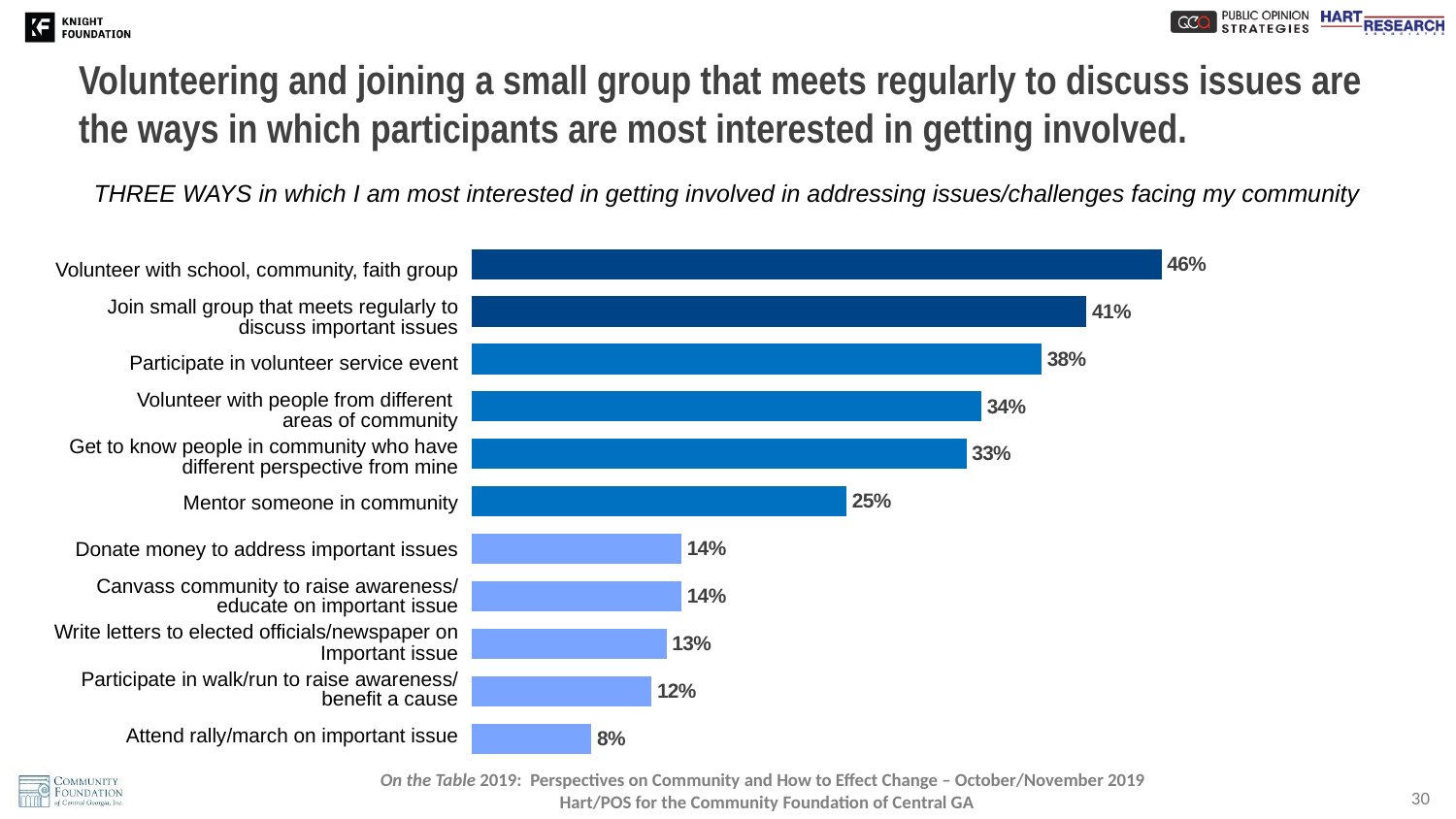
What percentage chose "Attend rally/march on important issue"? 8% What is the value for "Write letters to elected officials/newspaper on important issue"? 13% Which category has the highest value on the chart? Volunteer with school, community, faith group What percentage of participants are most interested in volunteering with a school, community, or faith group? 46% What is the value for "Mentor someone in community"? 25% Which is larger: the value for "Participate in volunteer service event" or the value for "Mentor someone in community"? Participate in volunteer service event Which category has the lowest value on the chart? Attend rally/march on important issue What is the difference between "Volunteer with school, community, faith group" and "Join small group that meets regularly to discuss important issues"? 5 percentage points What is the difference between "Donate money to address important issues" and "Attend rally/march on important issue"? 6 percentage points How many categories are shown on the chart? 11 How many categories on the chart are shown in the lighter blue colour? 5 What kind of chart is shown on the slide? Bar chart